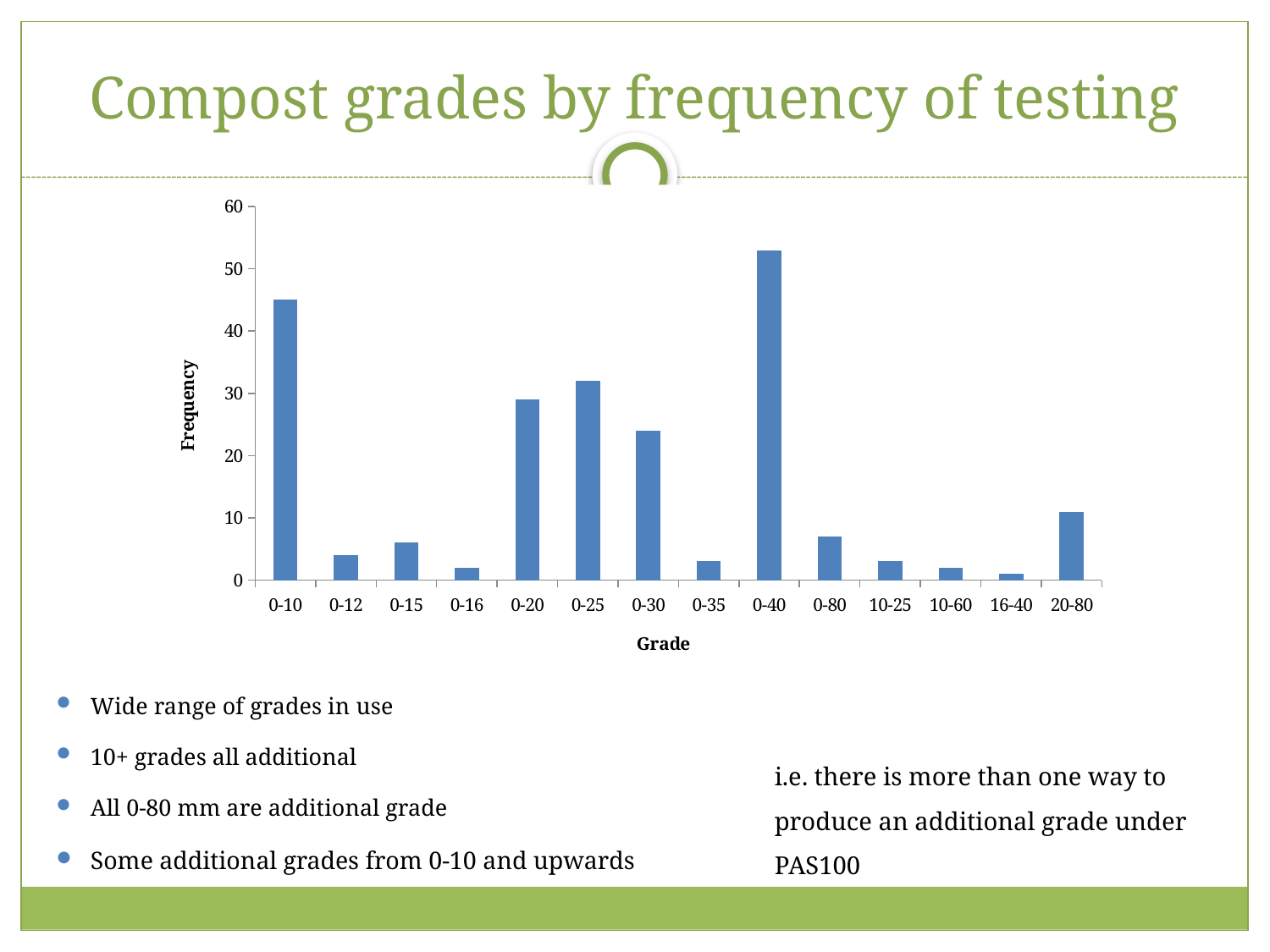
How many grade categories are shown on the x axis? 14 What is the label of the vertical axis? Frequency Which has a higher frequency, grade 0-10 or grade 0-20? 0-10 Is the frequency for grade 0-40 greater or less than 50? greater Is the frequency for grade 0-30 greater or less than 20? greater Which has a higher frequency, grade 0-25 or grade 0-30? 0-25 What is the label of the horizontal axis? Grade Is the frequency for grade 0-10 greater or less than 40? greater Which grade has the highest frequency? 0-40 What kind of chart is shown on the slide? bar chart